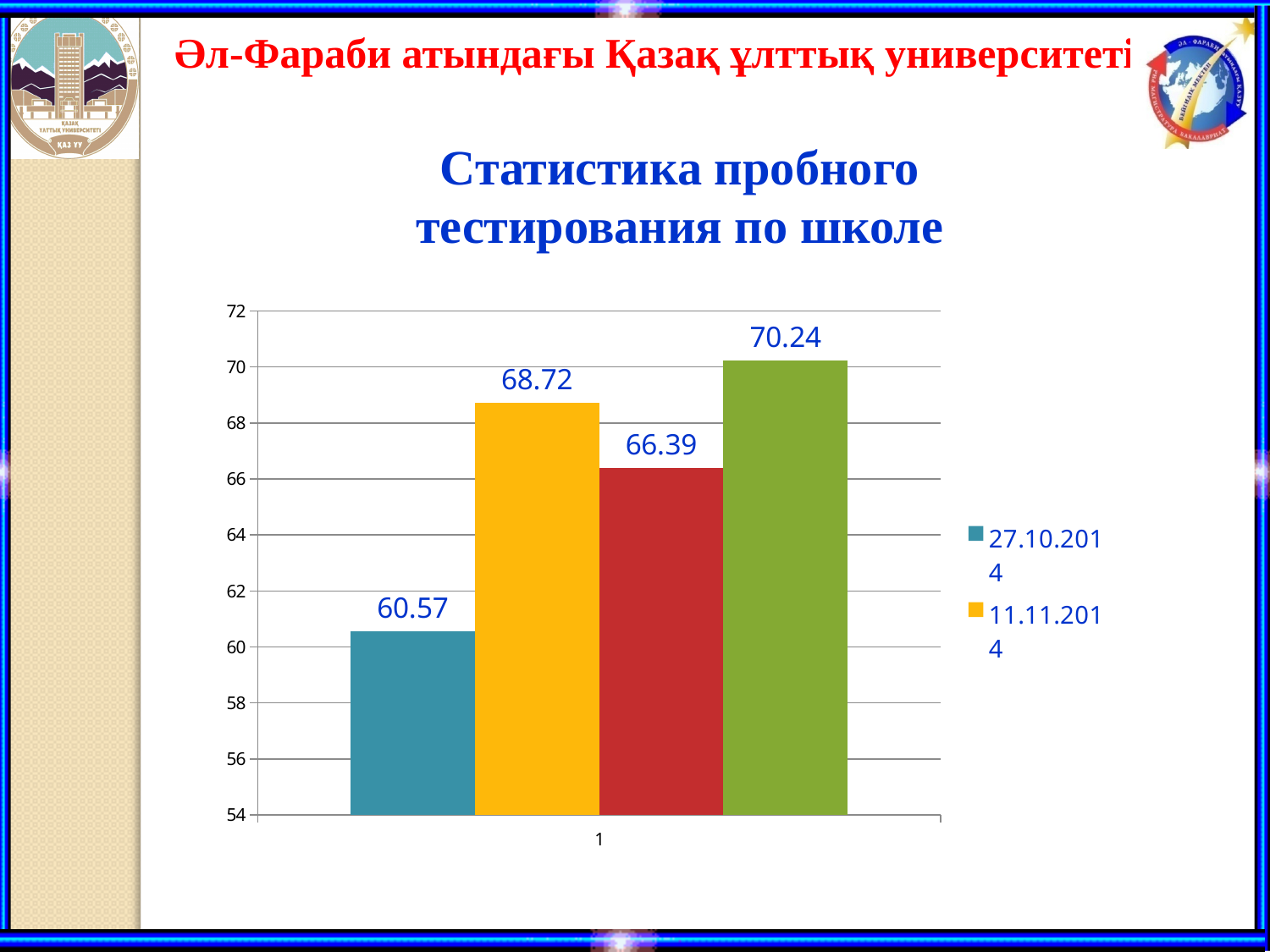
How many series entries are readable in the chart legend? 2 Which is larger, the value for 27.10.2014 or the value for 11.11.2014? 11.11.2014 Which legend series has the lowest value in the chart? 27.10.2014 Is the value for 27.10.2014 greater or less than 62? less What is the value of the bar for 27.10.2014? 60.57 What is the value of the bar for 11.11.2014? 68.72 How many bars are plotted in the chart? 4 What is the title of the chart on the slide? Статистика пробного тестирования по школе Is the value for 11.11.2014 greater or less than 68? greater What is the difference between the values for 11.11.2014 and 27.10.2014? 8.15 What type of chart is shown on the slide? bar chart What is the highest value labelled on any bar in the chart? 70.24